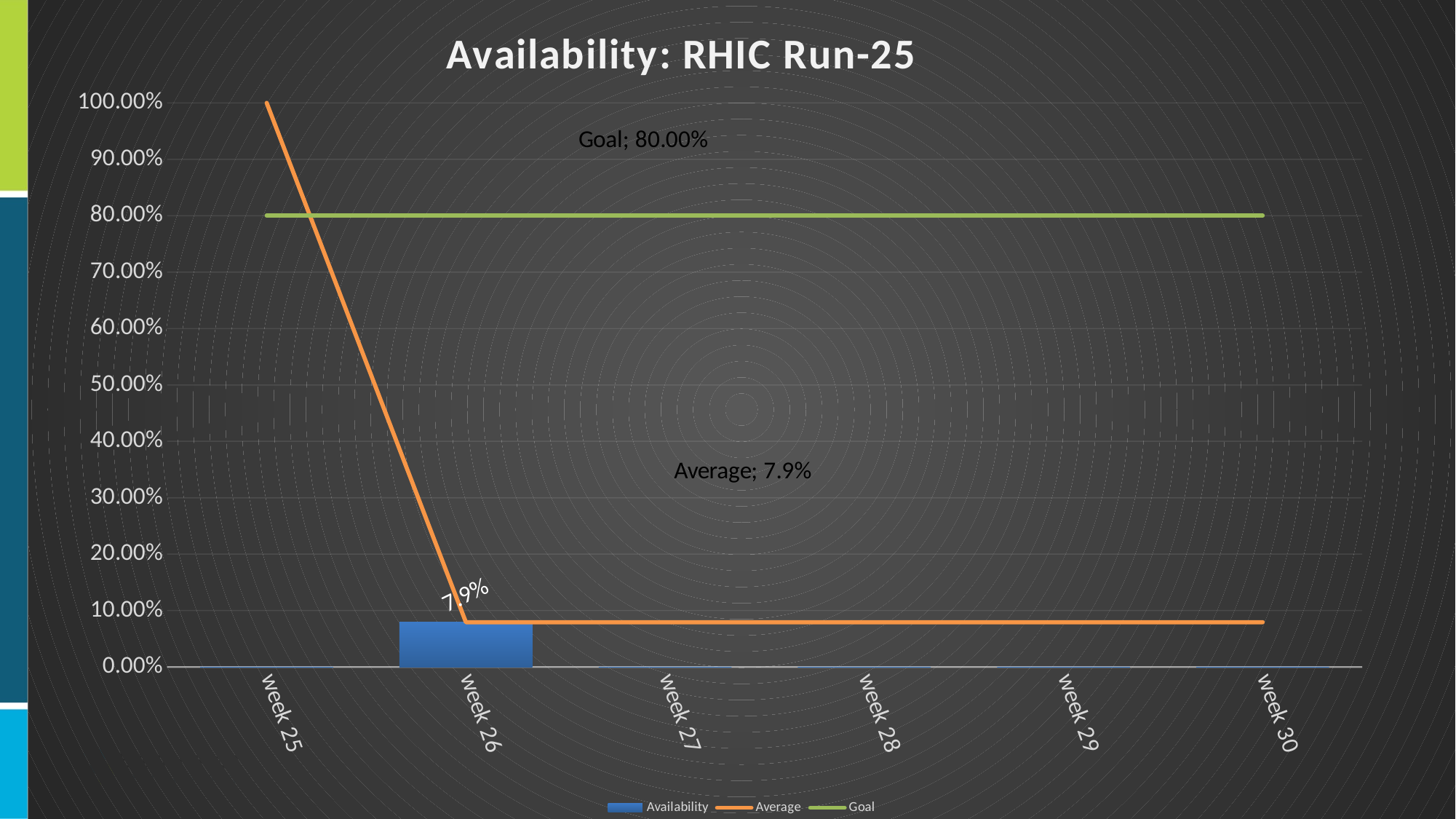
What is the title of the chart? Availability: RHIC Run-25 What is the difference between the labelled Goal value (80.00%) and the labelled Average value (7.9%)? 72.1% What is the Availability value labelled for week 26? 7.9% Does the Average line rise or fall from week 25 to week 26? fall Which week has the highest Availability bar? week 26 How many series does the chart's legend list? 3 How many weeks are shown on the x axis of the chart? 6 Which is larger at week 26, the Goal value or the Average value? Goal What value is labelled for the Goal series? 80.00% What value is labelled for the Average series? 7.9% What kind of chart is shown on the slide? Combined bar and line chart Is the Goal line greater or less than 50.00%? greater